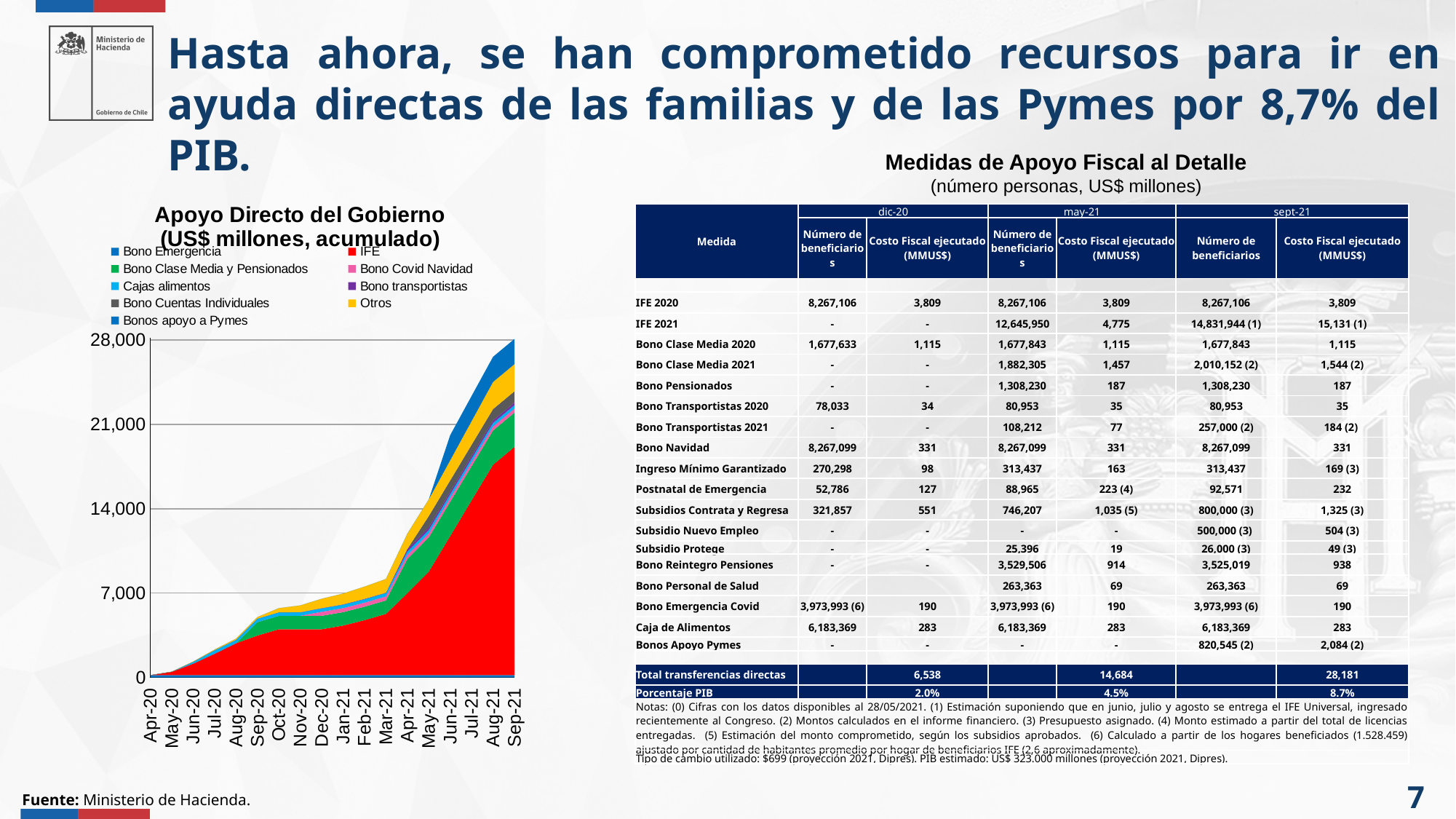
How many months are shown on the x axis of the 'Apoyo Directo del Gobierno' chart? 18 In the 'Apoyo Directo del Gobierno' chart, is the total accumulated value at Sep-21 greater or less than 21,000? greater In the 'Apoyo Directo del Gobierno' chart, do the accumulated values rise or fall from Apr-20 to Sep-21? Rise How many series does the legend of the 'Apoyo Directo del Gobierno' chart list? 9 What is the first month shown on the x axis of the 'Apoyo Directo del Gobierno' chart? Apr-20 In the 'Apoyo Directo del Gobierno' chart, which series accounts for the largest area at Sep-21? IFE What kind of chart is 'Apoyo Directo del Gobierno (US$ millones, acumulado)'? Stacked area chart In the 'Apoyo Directo del Gobierno' chart, is the total accumulated value at Jun-21 greater or less than 14,000? greater In the 'Apoyo Directo del Gobierno' chart, which is larger at Sep-21: IFE or Bono transportistas? IFE What is the last month shown on the x axis of the 'Apoyo Directo del Gobierno' chart? Sep-21 In the 'Apoyo Directo del Gobierno' chart, is the total accumulated value at Apr-21 greater or less than 7,000? greater